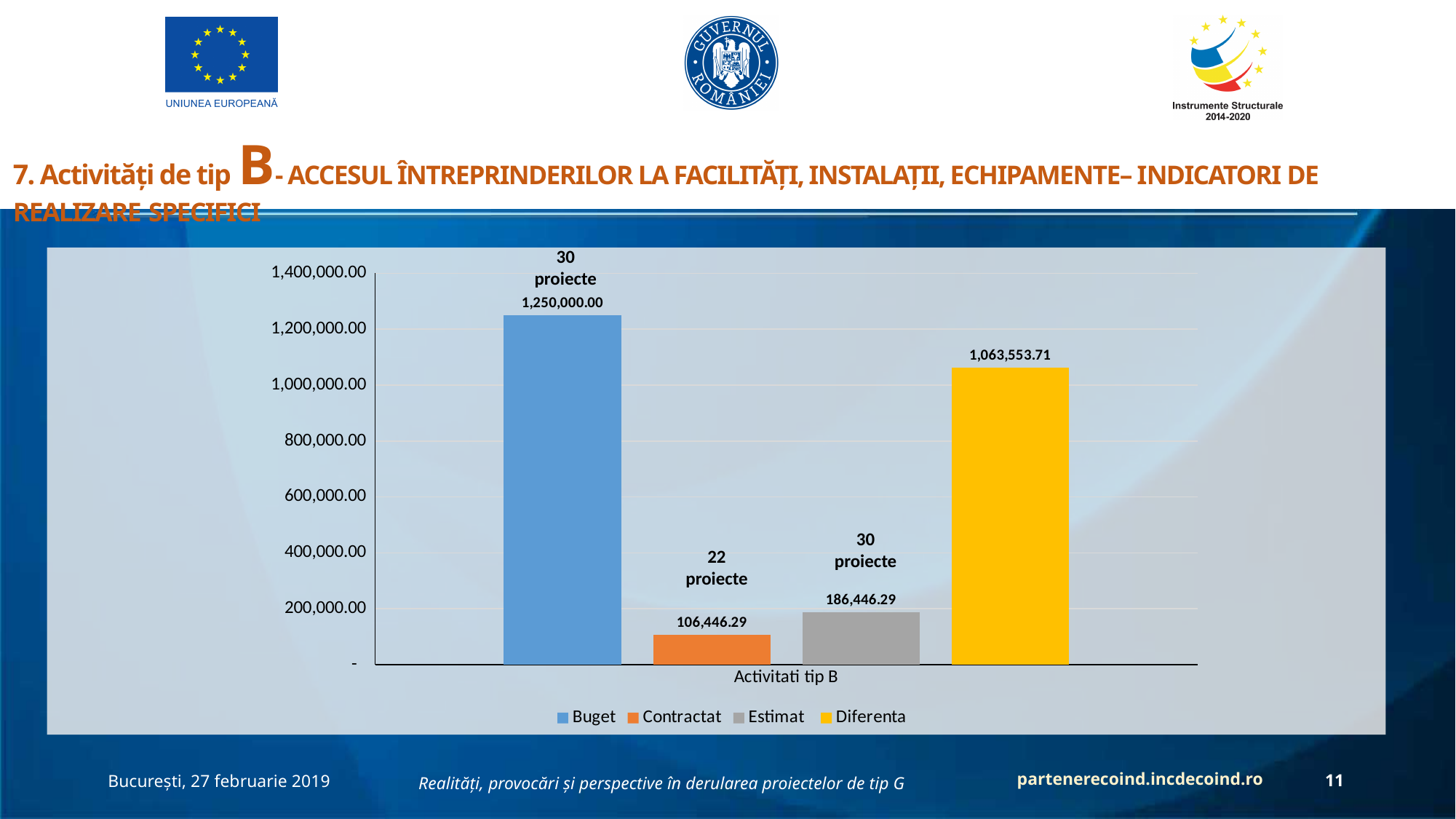
Which series has the lowest value? Contractat Which series has the highest value? Buget How many series does the legend list? 4 What is the value of the Estimat bar? 186,446.29 What is the difference between the Estimat and Contractat values? 80,000.00 Which is larger, the Diferenta value or the Estimat value? Diferenta What kind of chart is shown on the slide? Bar chart What is the difference between the Buget and Estimat values? 1,063,553.71 What is the value of the Diferenta bar? 1,063,553.71 What is the value of the Buget bar? 1,250,000.00 How many projects are annotated above the Contractat bar? 22 proiecte What is the value of the Contractat bar? 106,446.29